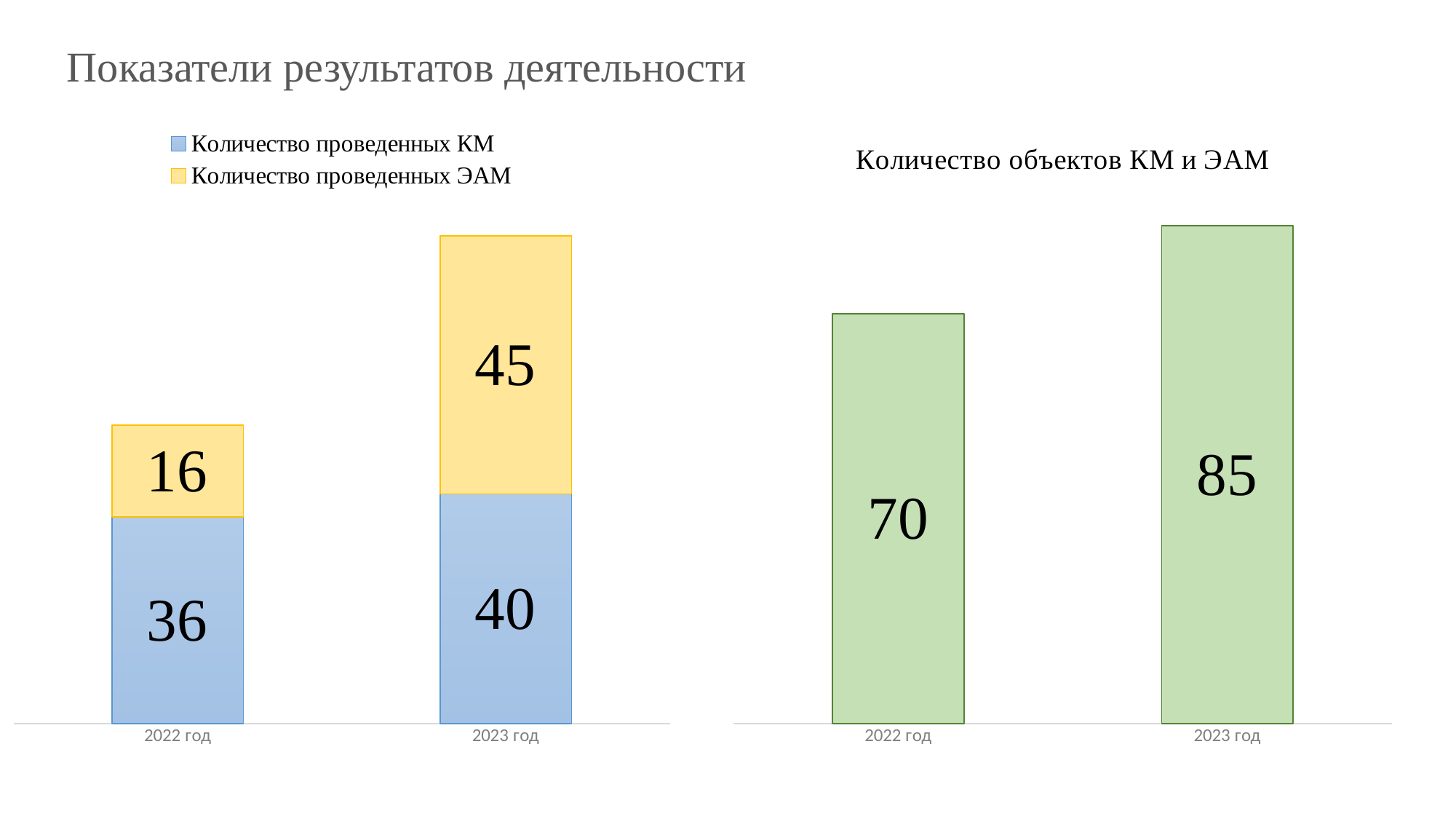
In the left stacked bar chart, what is the value of Количество проведенных КМ for 2022 год? 36 In the left stacked bar chart, what is the total of the stacked bar for 2022 год? 52 In the chart titled Количество объектов КМ и ЭАМ, what is the difference between 2023 год and 2022 год? 15 In the left stacked bar chart, what is the total of the stacked bar for 2023 год? 85 In the left stacked bar chart, how many series does the legend list? 2 In the left stacked bar chart, which series is shown in yellow? Количество проведенных ЭАМ In the left stacked bar chart, what is the value of Количество проведенных ЭАМ for 2023 год? 45 In the chart titled Количество объектов КМ и ЭАМ, what is the value for 2022 год? 70 In the chart titled Количество объектов КМ и ЭАМ, which year has the highest value? 2023 год In the chart titled Количество объектов КМ и ЭАМ, how many categories are shown on the x axis? 2 What kind of chart is the chart titled Количество объектов КМ и ЭАМ? Bar chart In the left stacked bar chart, what is the difference between Количество проведенных ЭАМ in 2023 год and in 2022 год? 29